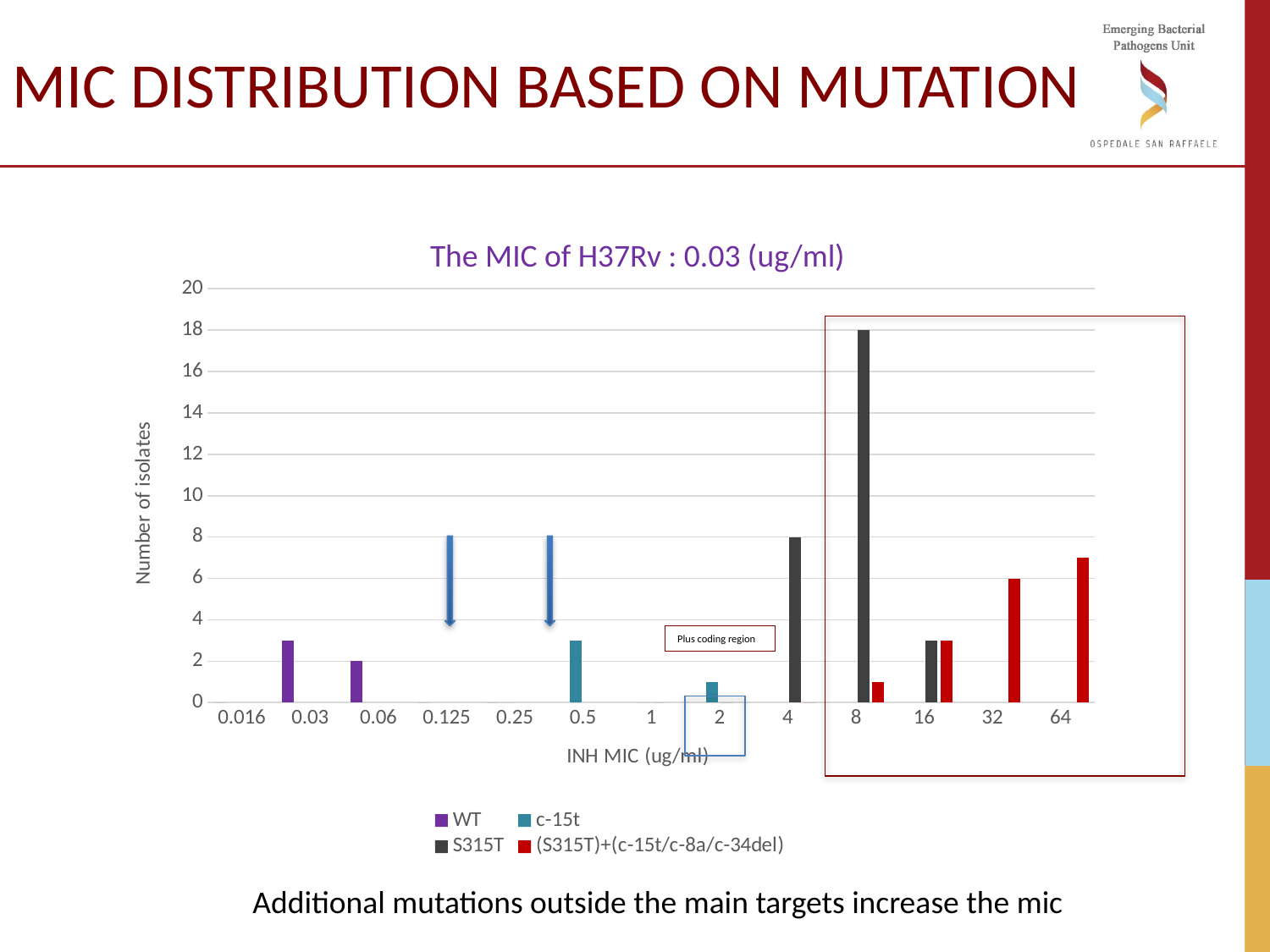
What is the number of isolates for the S315T series at an INH MIC of 4? 8 What is the number of isolates for the WT series at an INH MIC of 0.06? 2 What kind of chart is shown on the slide? bar chart What is the title of the chart? The MIC of H37Rv : 0.03 (ug/ml) Which is larger: the S315T bar at INH MIC 4 or the (S315T)+(c-15t/c-8a/c-34del) bar at INH MIC 32? S315T at INH MIC 4 How many MIC categories are shown on the x axis? 13 Is the value for the (S315T)+(c-15t/c-8a/c-34del) series at INH MIC 64 greater or less than 6? greater What is the number of isolates for the S315T series at an INH MIC of 8? 18 What is the number of isolates for the (S315T)+(c-15t/c-8a/c-34del) series at an INH MIC of 32? 6 How many series does the chart legend list? 4 What is the difference between the S315T bars at INH MIC 8 and INH MIC 4? 10 At which INH MIC value does the tallest bar in the chart occur? 8